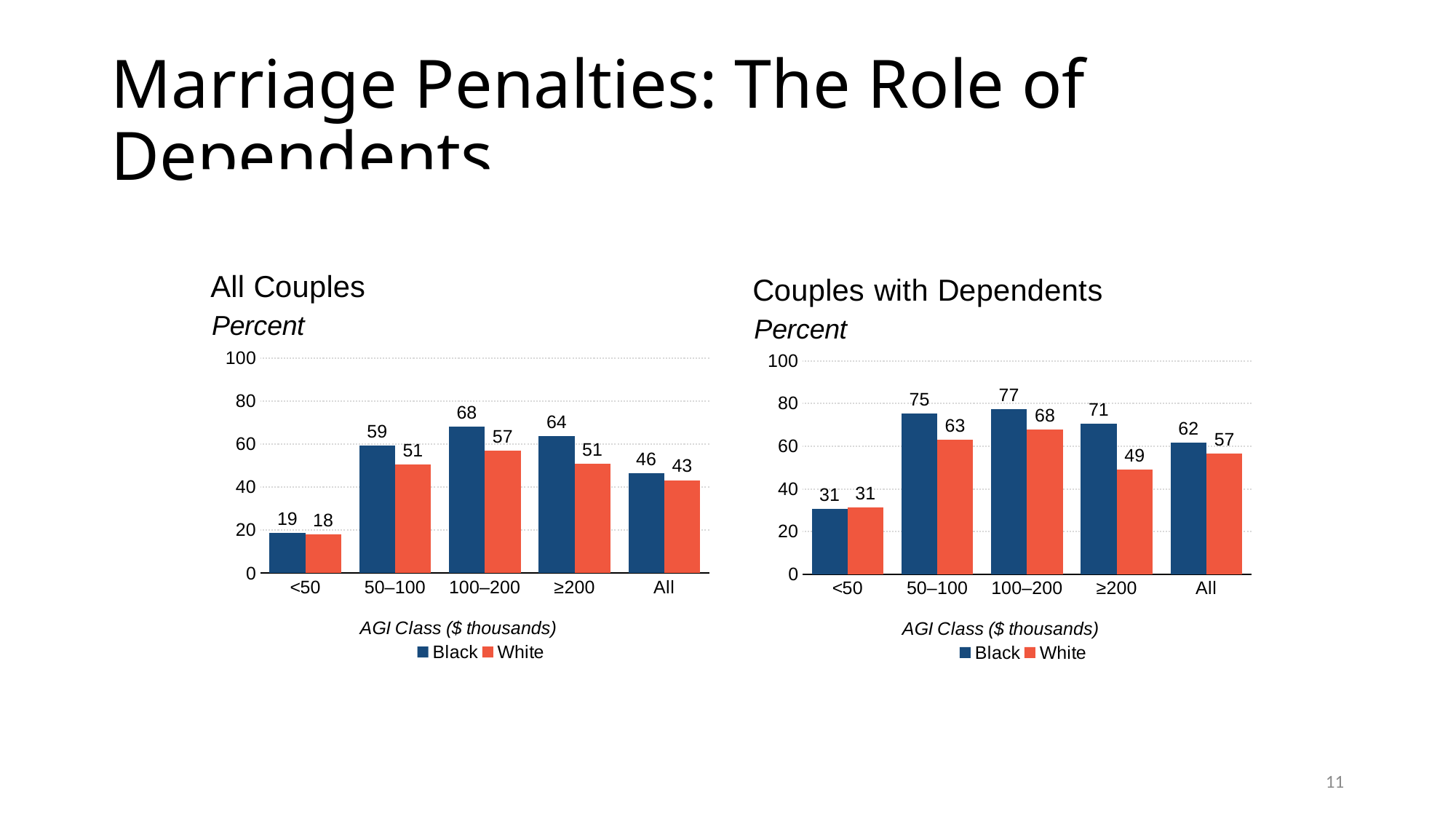
What kind of chart is the All Couples chart? Bar chart In the All Couples chart, which AGI class has the highest value for Black couples? 100–200 In the Couples with Dependents chart, which AGI class has the lowest value for White couples? <50 In the All Couples chart, what is the difference between the Black and White values for the All category? 3 How many series does the legend of the Couples with Dependents chart list? 2 In the Couples with Dependents chart, what is the difference between the Black and White values in the ≥200 AGI class? 22 In the Couples with Dependents chart, what is the value for White couples in the ≥200 AGI class? 49 In the All Couples chart, which is larger in the 50–100 AGI class, the Black value or the White value? Black In the All Couples chart, what is the value for Black couples in the 100–200 AGI class? 68 How many AGI class categories are shown on the x axis of the All Couples chart? 5 In the Couples with Dependents chart, is the value for Black couples in the 100–200 AGI class greater or less than 60? greater What is the x-axis label of the Couples with Dependents chart? AGI Class ($ thousands)